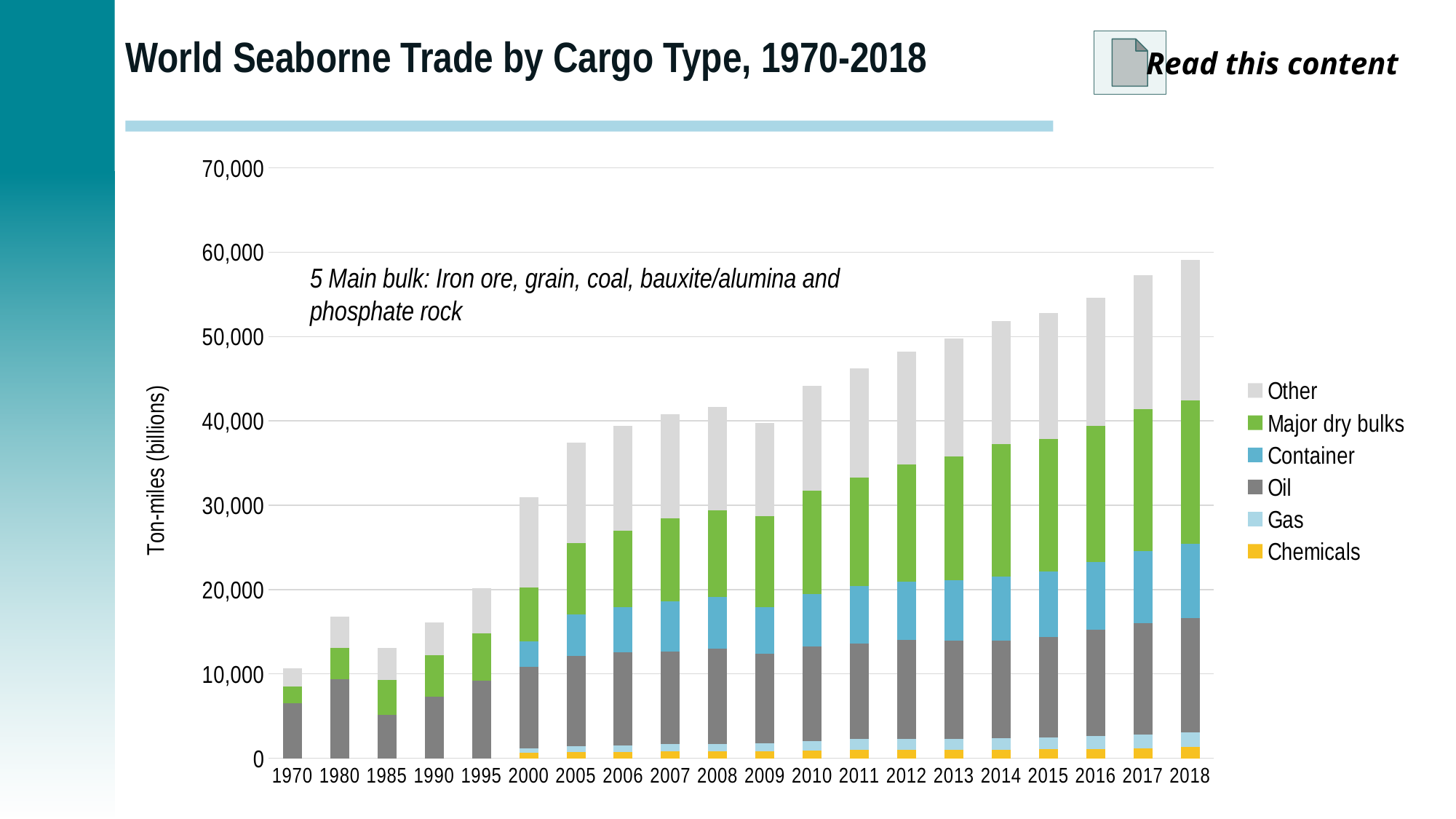
Which year has the highest total seaborne trade? 2018 Is the total value for 1970 greater or less than 20,000? less How many years are shown along the x axis? 20 What is the label on the y axis? Ton-miles (billions) Do the total values generally rise or fall from 1970 to 2018? Rise Which year has the larger total, 2009 or 2010? 2010 Which year has the lowest total seaborne trade? 1970 What kind of chart is shown on the slide? Stacked bar chart Is the total value for 2010 greater or less than 40,000? greater How many series does the legend list? 6 Is the total value for 2018 greater or less than 50,000? greater Which series is listed first in the legend? Other